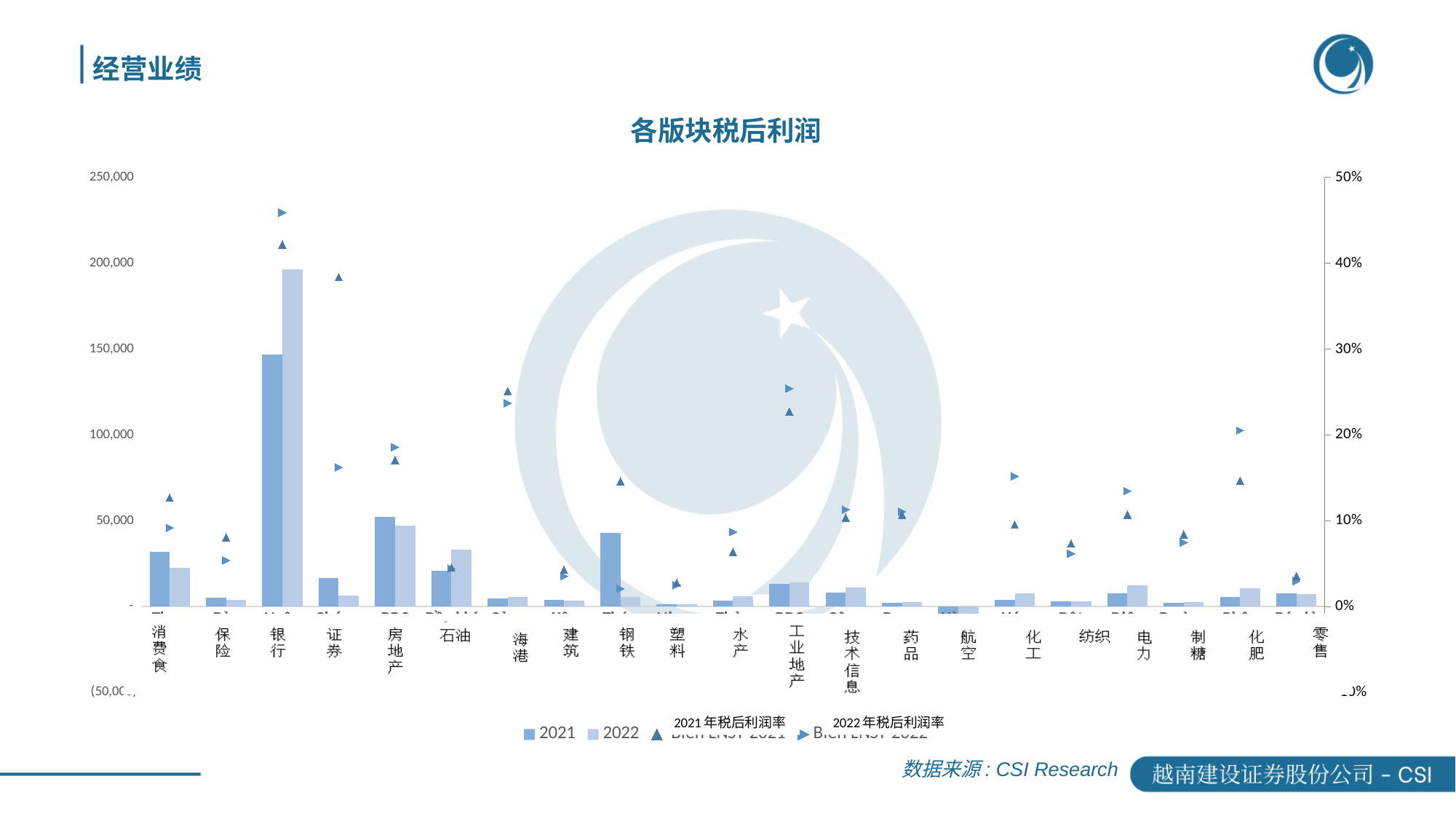
How many sector categories are shown on the x axis? 21 Is the 2021 after-tax profit bar for 钢铁 greater or less than 50,000? less What is the title of the chart? 各版块税后利润 How many series does the legend list? 4 Is the 2021 after-tax profit bar for 银行 greater or less than 100,000? greater Is the 2022 after-tax profit margin marker for 银行 greater or less than 40%? greater Which sector has the highest 2022 after-tax profit bar? 银行 For 银行, which bar is larger, 2021 or 2022? 2022 For 钢铁, which bar is larger, 2021 or 2022? 2021 What kind of chart is shown on the slide? A bar chart combined with markers (combo chart) Which sector has the highest 2021 after-tax profit bar? 银行